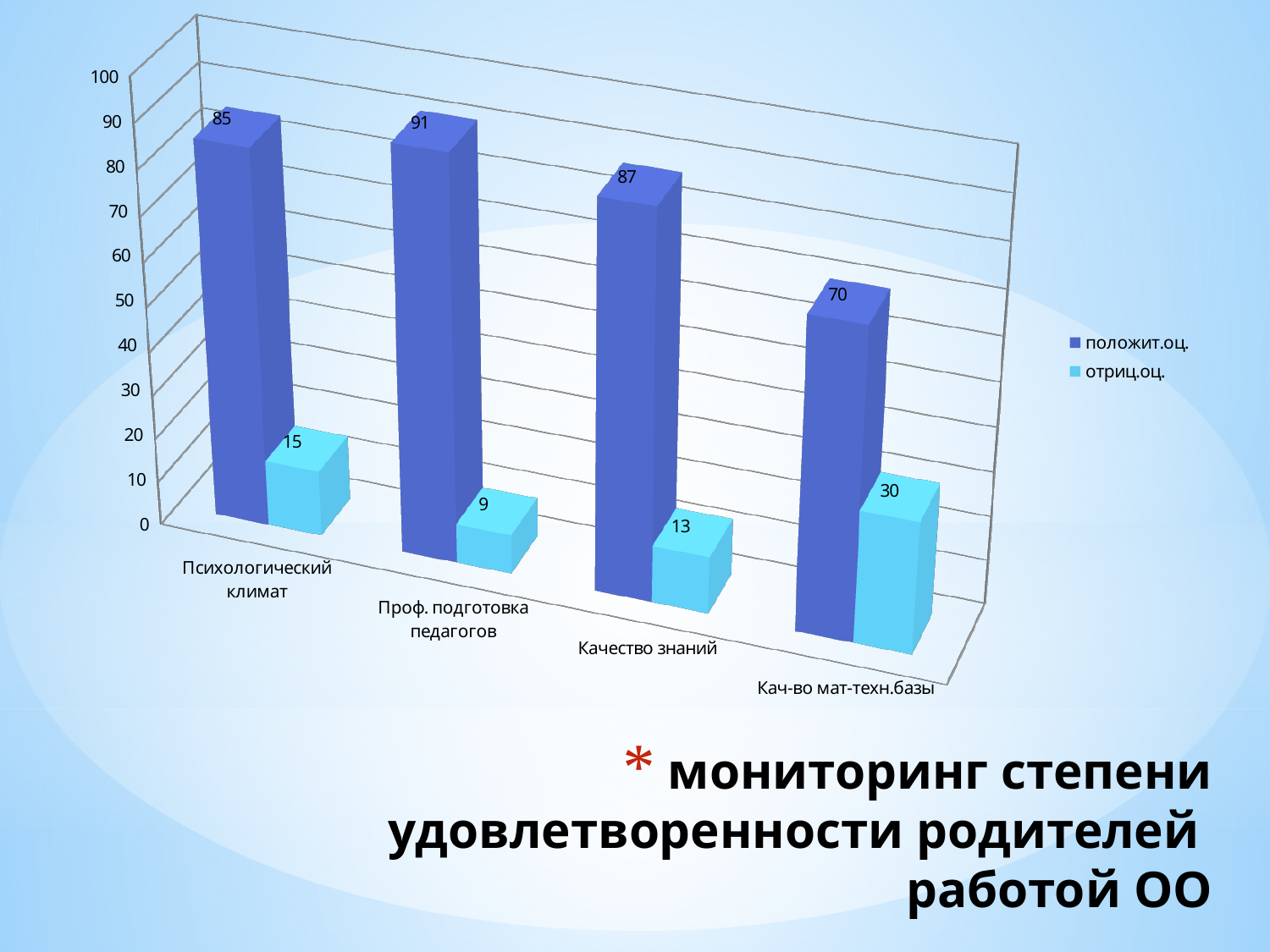
What kind of chart is shown on the slide? Bar chart How many series does the legend list? 2 What is the value of отриц.оц. for Кач-во мат-техн.базы? 30 Which is larger: отриц.оц. for Психологический климат or отриц.оц. for Качество знаний? Психологический климат How many categories are shown on the x axis? 4 What is the difference between положит.оц. and отриц.оц. for Кач-во мат-техн.базы? 40 What are the two series named in the legend? положит.оц. and отриц.оц. What is the value of отриц.оц. for Проф. подготовка педагогов? 9 Which category has the lowest отриц.оц. value? Проф. подготовка педагогов What is the value of положит.оц. for Психологический климат? 85 What is the value of положит.оц. for Качество знаний? 87 Which category has the highest положит.оц. value? Проф. подготовка педагогов